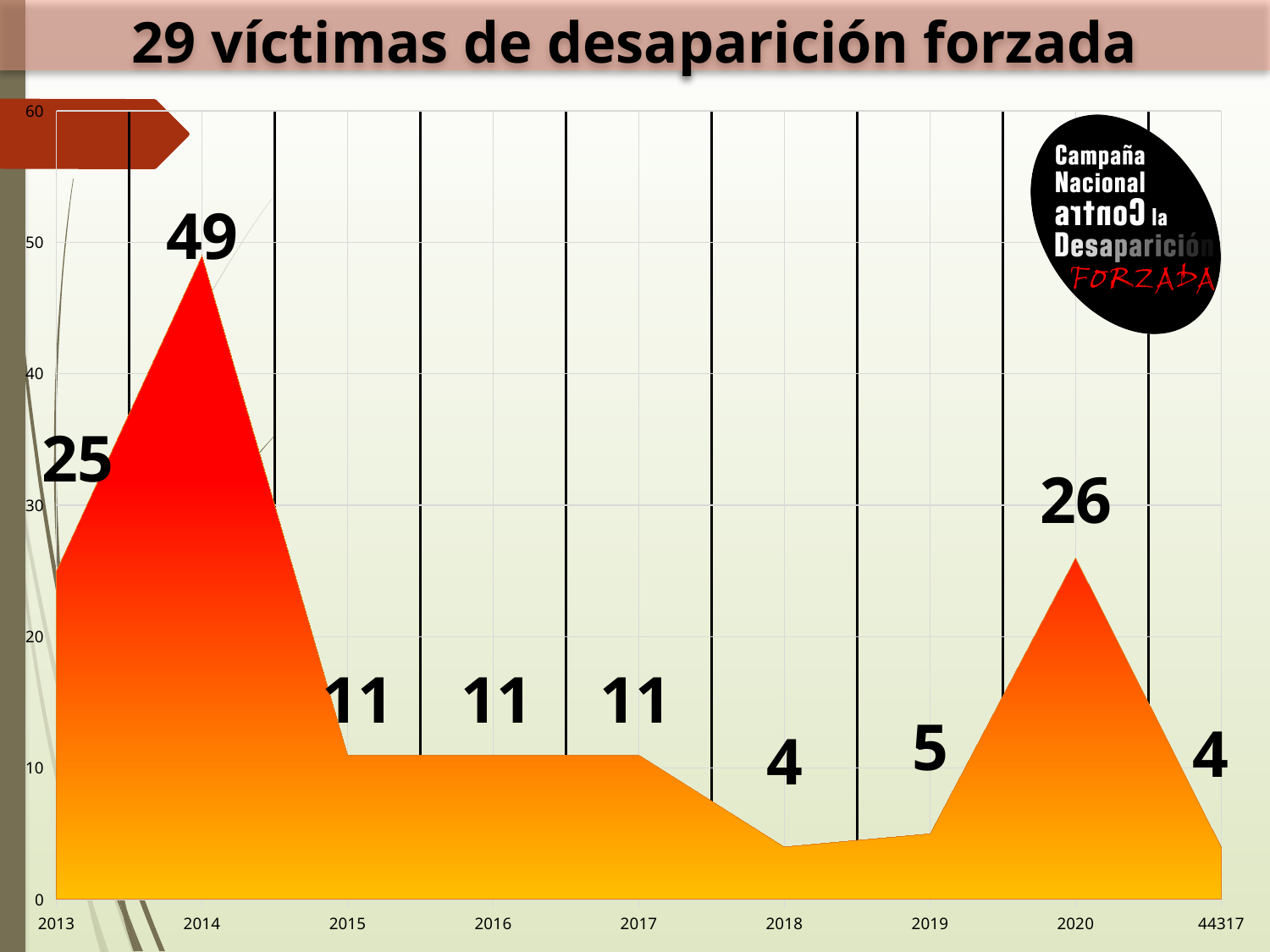
What is the value for 2014? 49 What is the value for 2020? 26 What is the title of the slide? 29 víctimas de desaparición forzada Is the value for 2014 greater or less than 40? greater What is the value for 2018? 4 How many points are plotted along the x axis? 9 Which is larger, the value for 2013 or the value for 2020? 2020 What is the difference between the values for 2014 and 2013? 24 Do the values rise or fall from 2014 to 2015? Fall What is the difference between the values for 2020 and 2019? 21 Which year has the highest value? 2014 What kind of chart is shown on the slide? Area chart